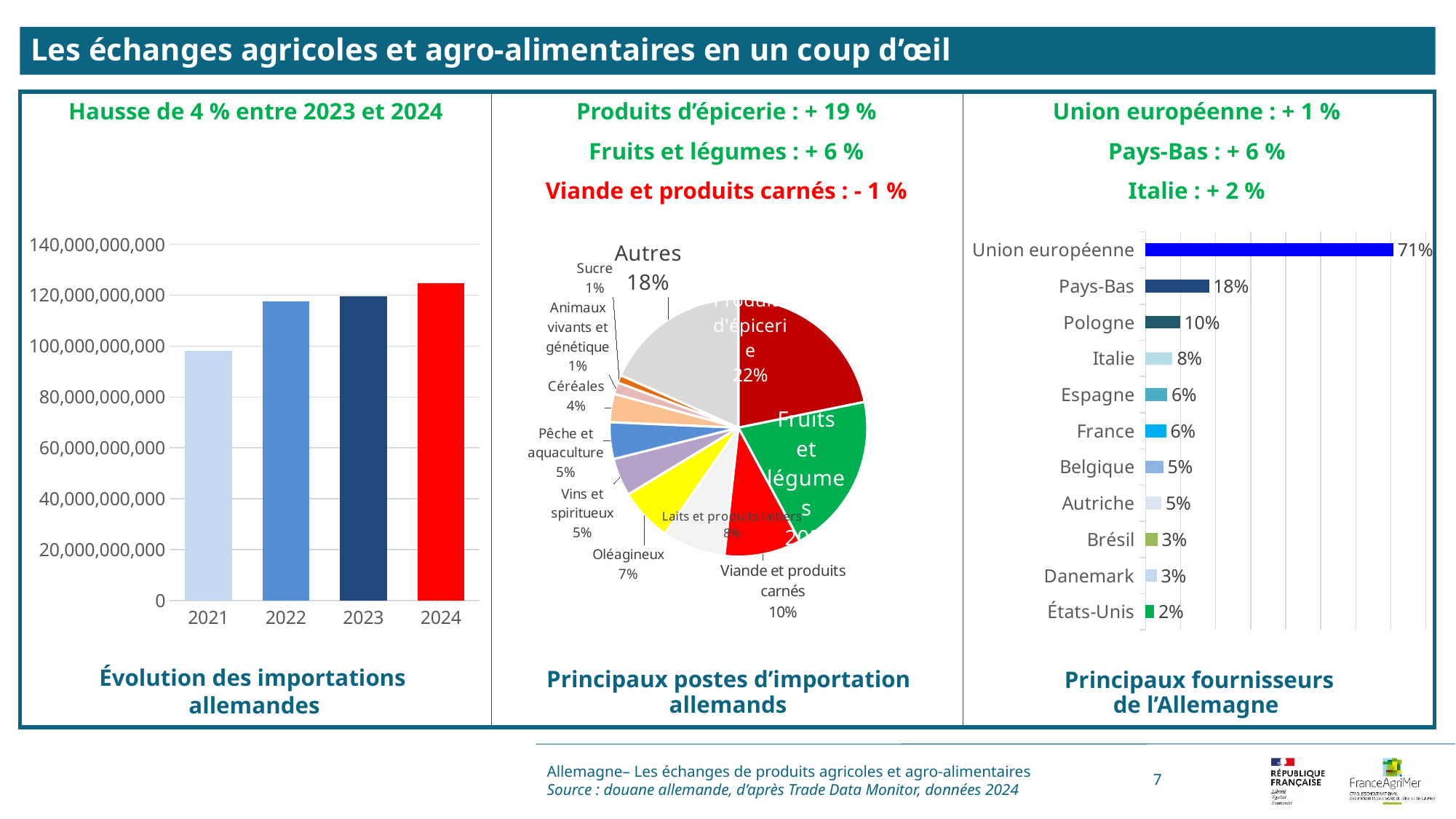
In the chart 'Évolution des importations allemandes', which year has the highest bar? 2024 In the chart 'Évolution des importations allemandes', which year has the lowest bar? 2021 In the chart 'Évolution des importations allemandes', do the values rise or fall from 2021 to 2024? rise In the chart 'Évolution des importations allemandes', how many years are shown on the x axis? 4 In the chart 'Principaux fournisseurs de l'Allemagne', what is the value for Pologne? 10% In the pie chart 'Principaux postes d'importation allemands', what is the difference between the shares of 'Autres' and 'Oléagineux'? 11% In the pie chart 'Principaux postes d'importation allemands', what share does 'Produits d'épicerie' have? 22% In the pie chart 'Principaux postes d'importation allemands', what share does 'Viande et produits carnés' have? 10% What kind of chart is 'Principaux fournisseurs de l'Allemagne'? bar chart In the chart 'Évolution des importations allemandes', is the value for 2021 greater or less than 100,000,000,000? less In the chart 'Principaux fournisseurs de l'Allemagne', what is the difference between Union européenne and Pays-Bas? 53% In the chart 'Évolution des importations allemandes', is the value for 2024 greater or less than 120,000,000,000? greater